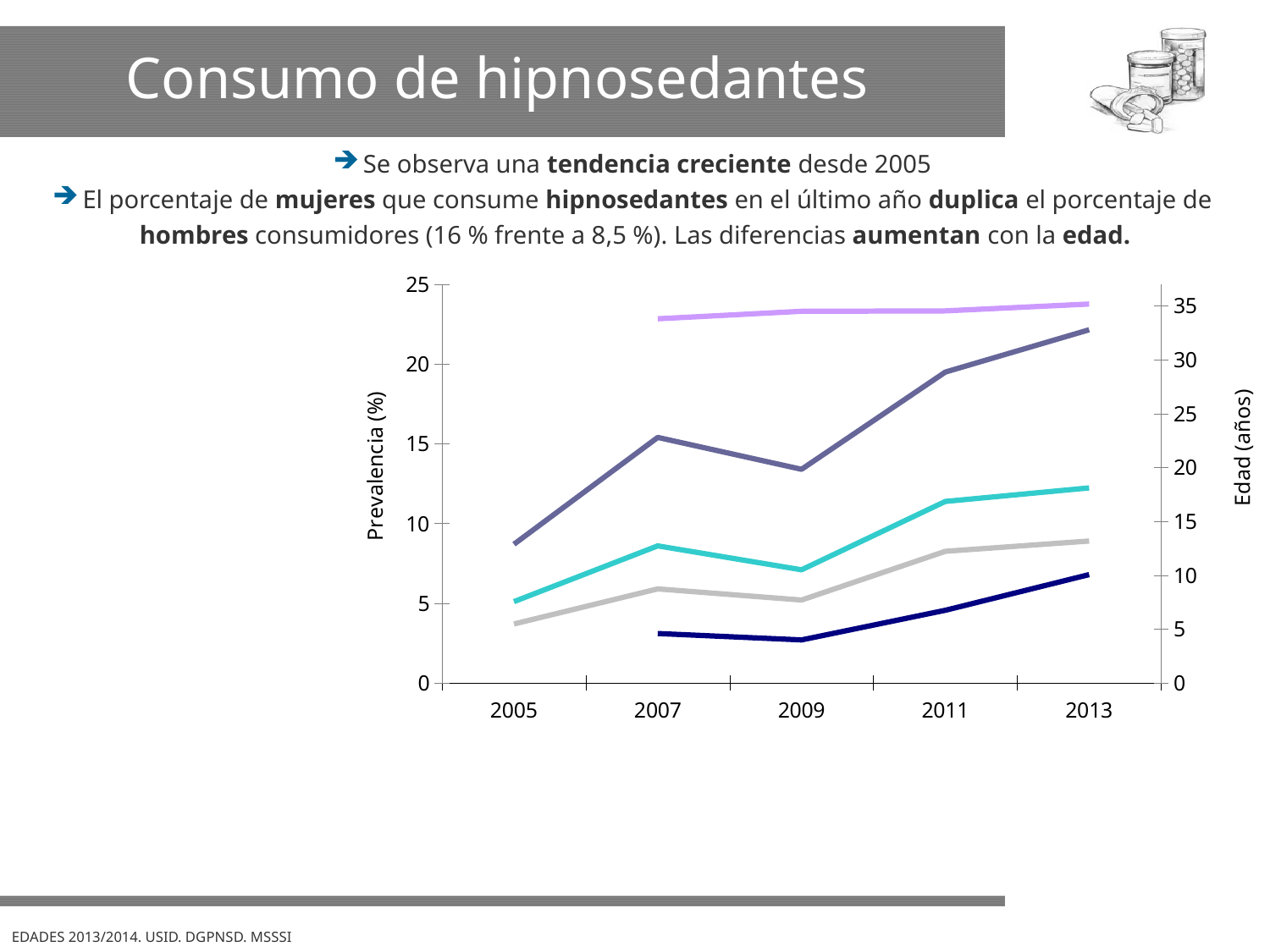
On the left axis, is the value of the cyan line in 2005 greater or less than 10? less In 2013, which is higher on the chart, the cyan line or the grey line? the cyan line Which line is the highest on the chart in 2013? the light purple line What is the title of the right vertical axis of the chart? Edad (años) On the left axis, is the value of the dark navy line in 2009 greater or less than 5? less How many years are labelled on the x axis of the chart? 5 Which line is the lowest on the chart in 2013? the dark navy line Does the cyan line rise or fall between 2007 and 2009? falls Does the dark slate-purple line rise or fall between 2009 and 2013? rises What is the title of the left vertical axis of the chart? Prevalencia (%) What kind of chart is shown on the slide? line chart On the left axis, is the value of the dark slate-purple line in 2013 greater or less than 20? greater